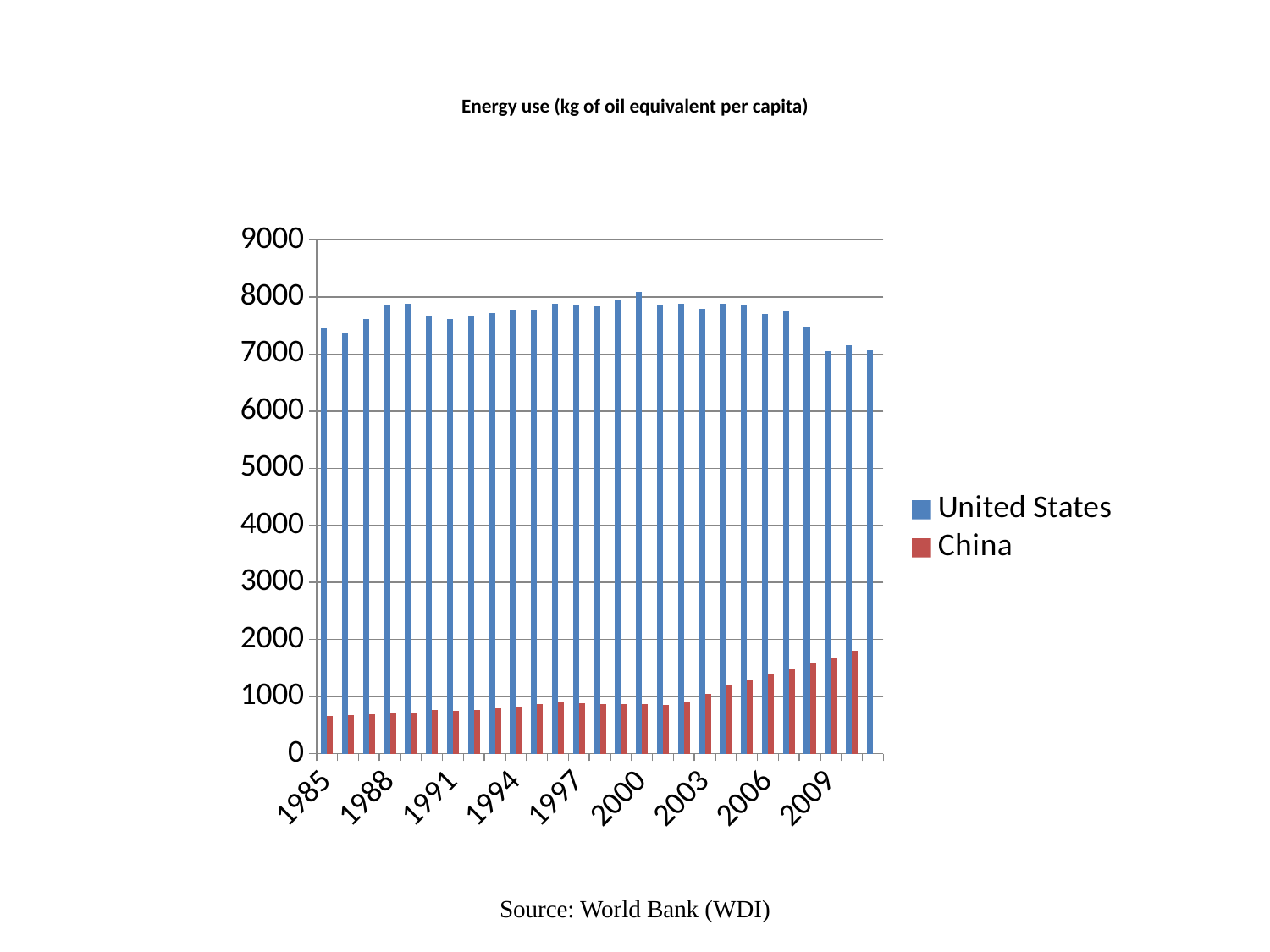
In which labelled year does the United States reach its highest value? 2000 How many series does the legend list? 2 Is the value for China in 1994 greater or less than 1000? less Is the value for the United States in 1985 greater or less than 7000? greater What kind of chart is shown on the slide? bar chart Do the values for China rise or fall from 1985 to the end of the period? rise Is the value for China in 1985 greater or less than 1000? less Which series has the larger value in 2003, United States or China? United States What is the title of the chart? Energy use (kg of oil equivalent per capita) Which series is shown in red? China